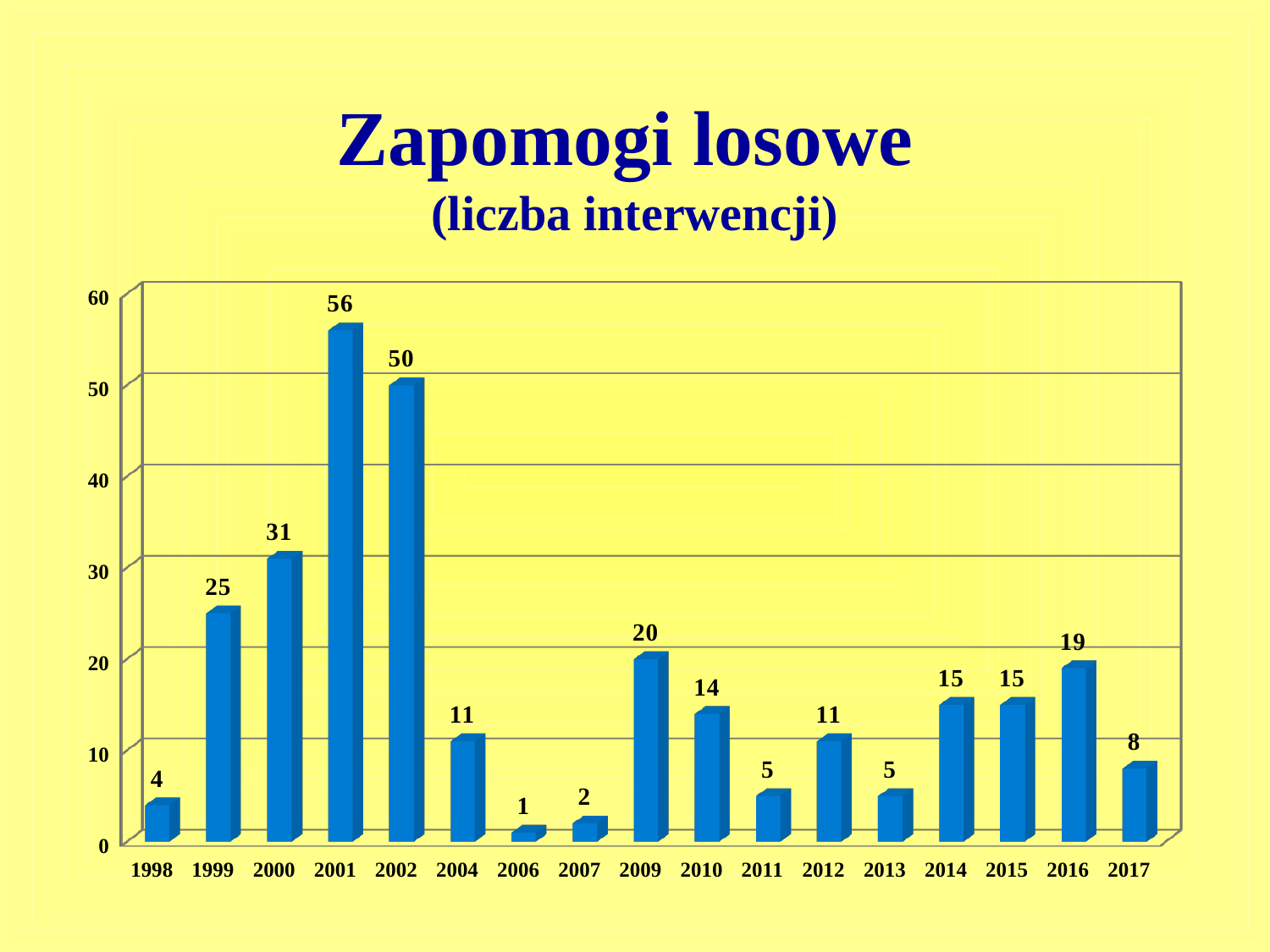
How many years are shown on the x axis? 17 What is the value for 2009? 20 What is the title of the chart? Zapomogi losowe (liczba interwencji) What is the difference between the values for 2016 and 2017? 11 What is the difference between the values for 2001 and 2002? 6 Which year has the highest value? 2001 What is the value for 2017? 8 Is the value for 2000 greater or less than 30? greater Which year has the lowest value? 2006 Which is larger, the value for 1999 or the value for 2010? 1999 What kind of chart is shown on the slide? bar chart What is the value for 2001? 56